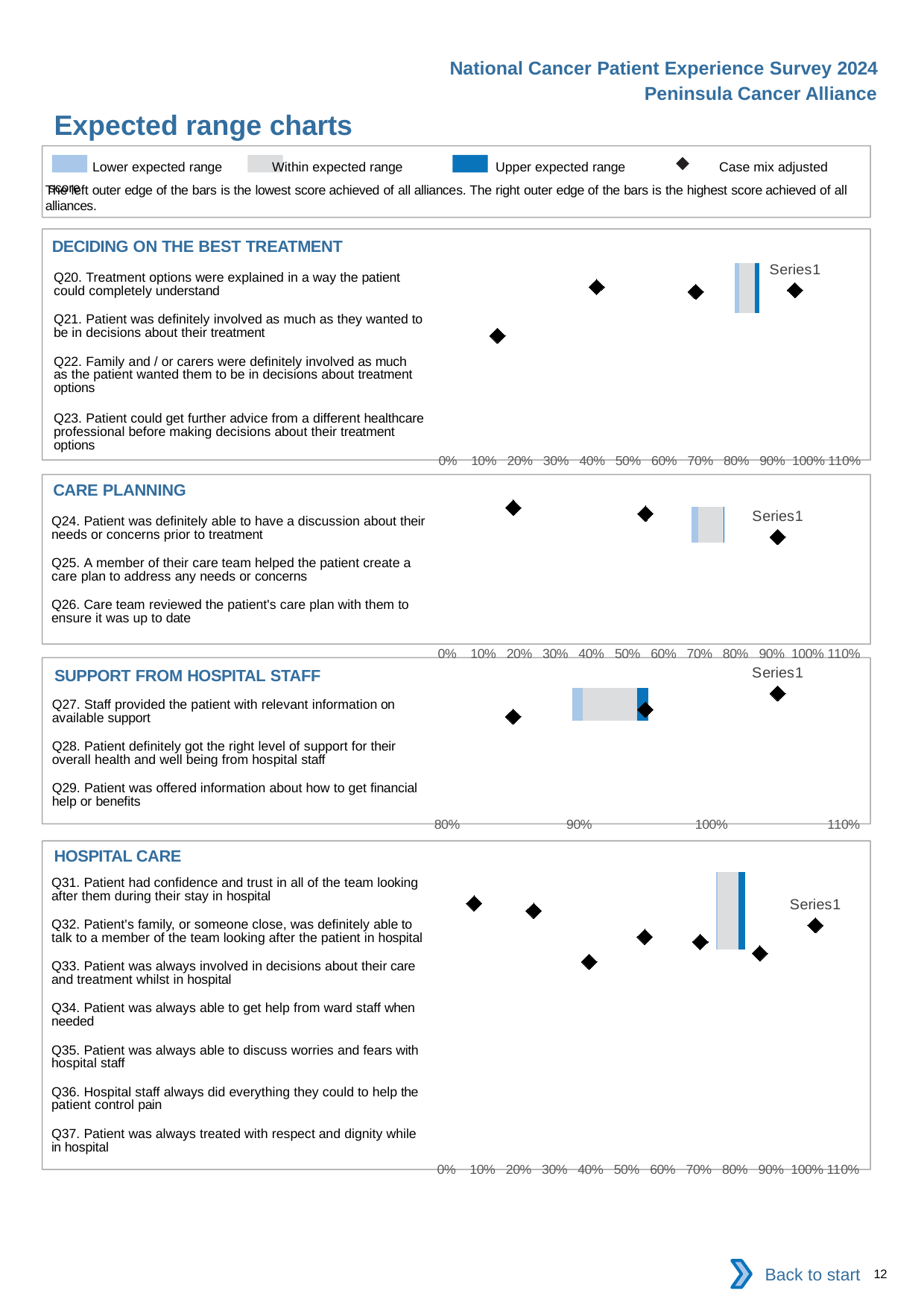
In the SUPPORT FROM HOSPITAL STAFF chart, how many questions (categories) are listed? 3 How many charts are shown on the slide? 4 In the CARE PLANNING chart, how many questions (categories) are listed? 3 In the HOSPITAL CARE chart, is the right edge of the expected range bar greater or less than 70%? greater In the HOSPITAL CARE chart, what is the highest value shown on the x axis? 110% In the SUPPORT FROM HOSPITAL STAFF chart, what is the lowest value shown on the x axis? 80% How many entries does the legend at the top of the slide list? 4 In the SUPPORT FROM HOSPITAL STAFF chart, is the left edge of the expected range bar greater or less than 80%? greater